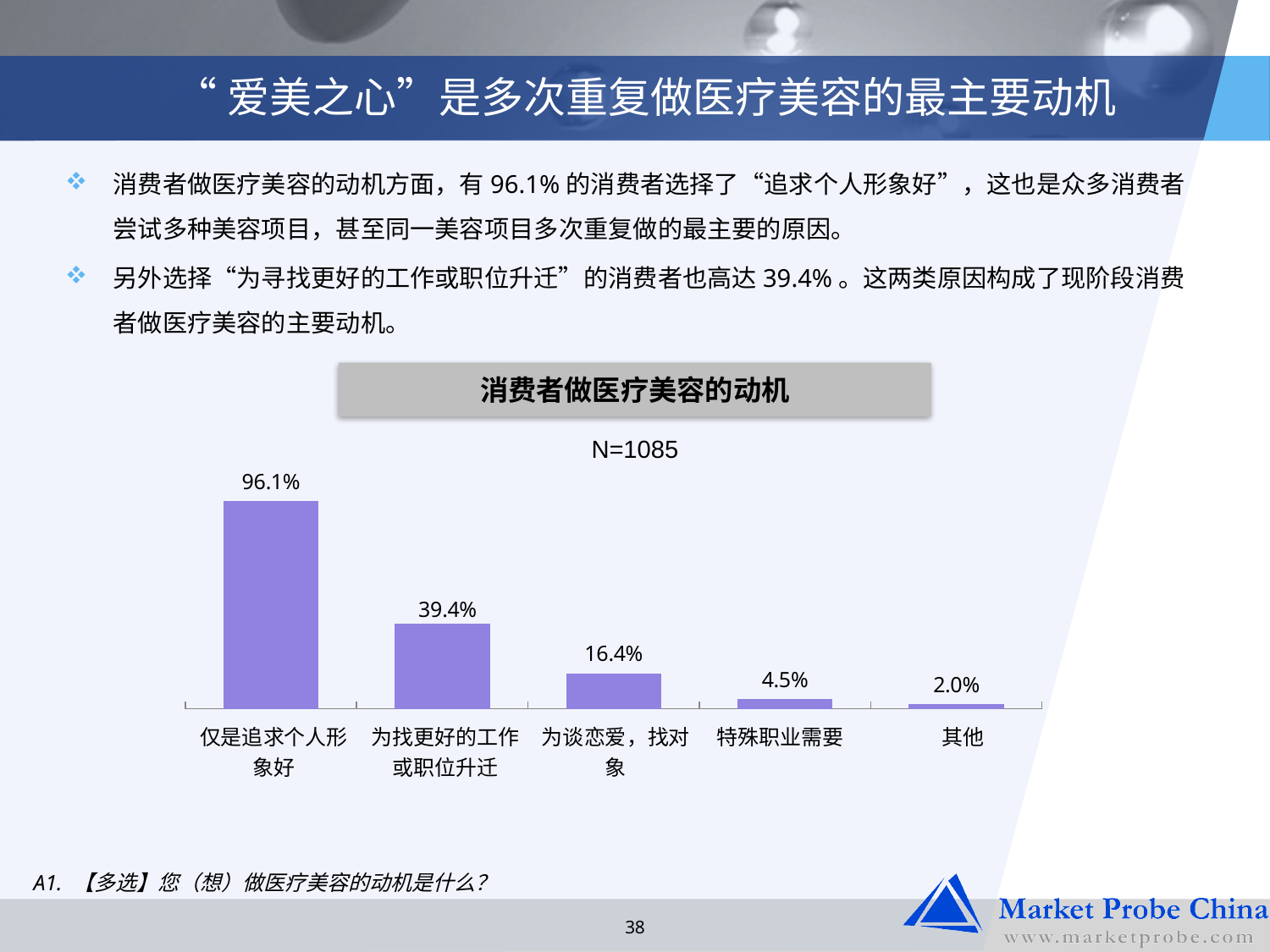
What is the value for 为找更好的工作或职位升迁? 39.4% What is the title of the chart? 消费者做医疗美容的动机 How many categories are shown in the chart? 5 What is the value for 特殊职业需要? 4.5% What is the difference between the values for 仅是追求个人形象好 and 为找更好的工作或职位升迁? 56.7% What is the value for 为谈恋爱，找对象? 16.4% What is the value for 其他? 2.0% What is the value for 仅是追求个人形象好? 96.1% Which category has the highest value? 仅是追求个人形象好 Which is larger, the value for 为谈恋爱，找对象 or the value for 特殊职业需要? 为谈恋爱，找对象 Which category has the lowest value? 其他 What kind of chart is shown on the slide? Bar chart